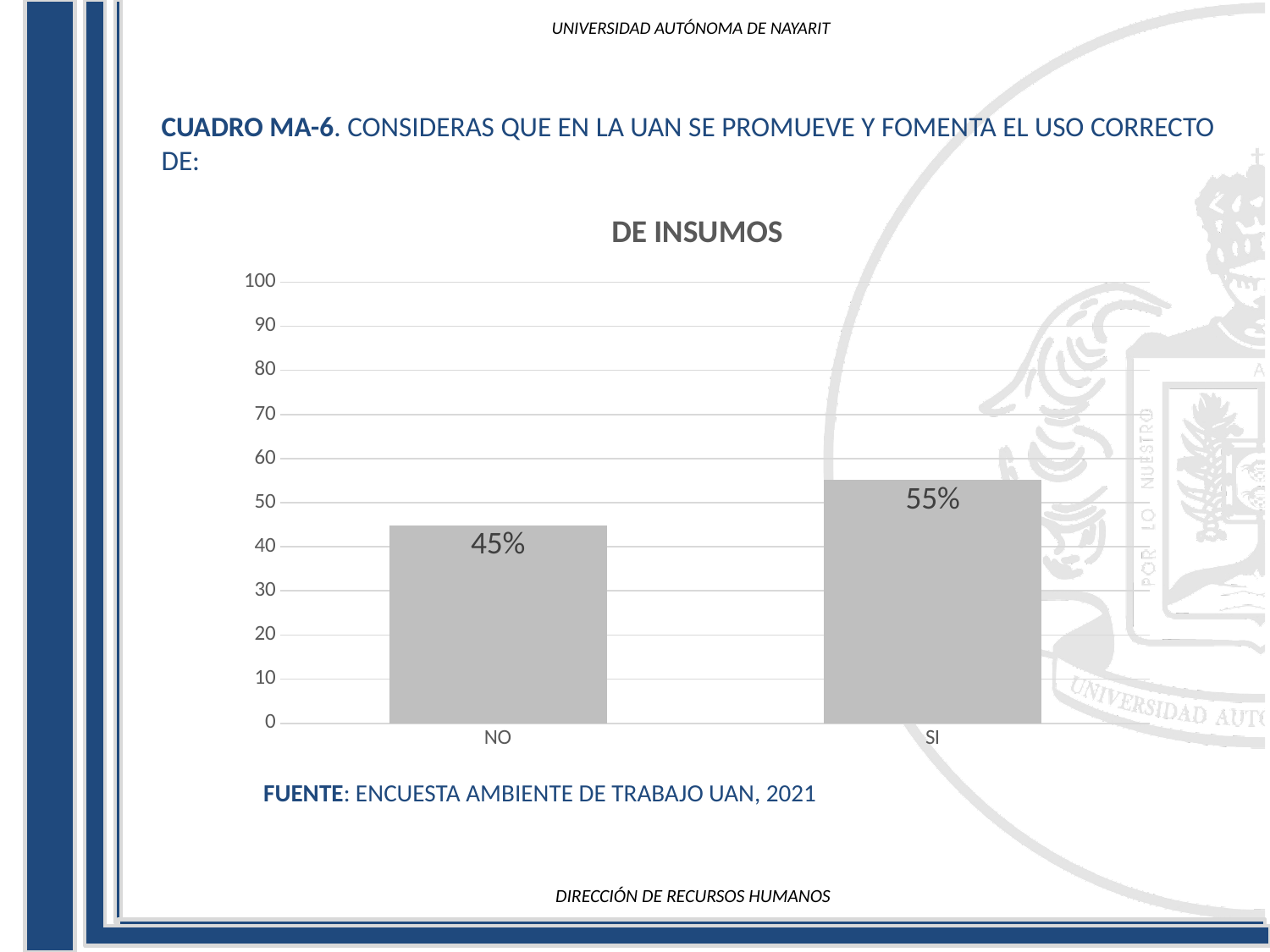
Which is larger, the value for NO or the value for SI? SI What is the value for SI? 55% Is the value for NO greater or less than 50? less Which category has the lowest value? NO How many categories are shown on the x axis? 2 What is the title of the chart? DE INSUMOS What is the difference between the values for SI and NO? 10% What is the highest value shown on the vertical axis? 100 Is the value for SI greater or less than 50? greater What kind of chart is shown on the slide? bar chart What is the value for NO? 45% Which category has the highest value? SI